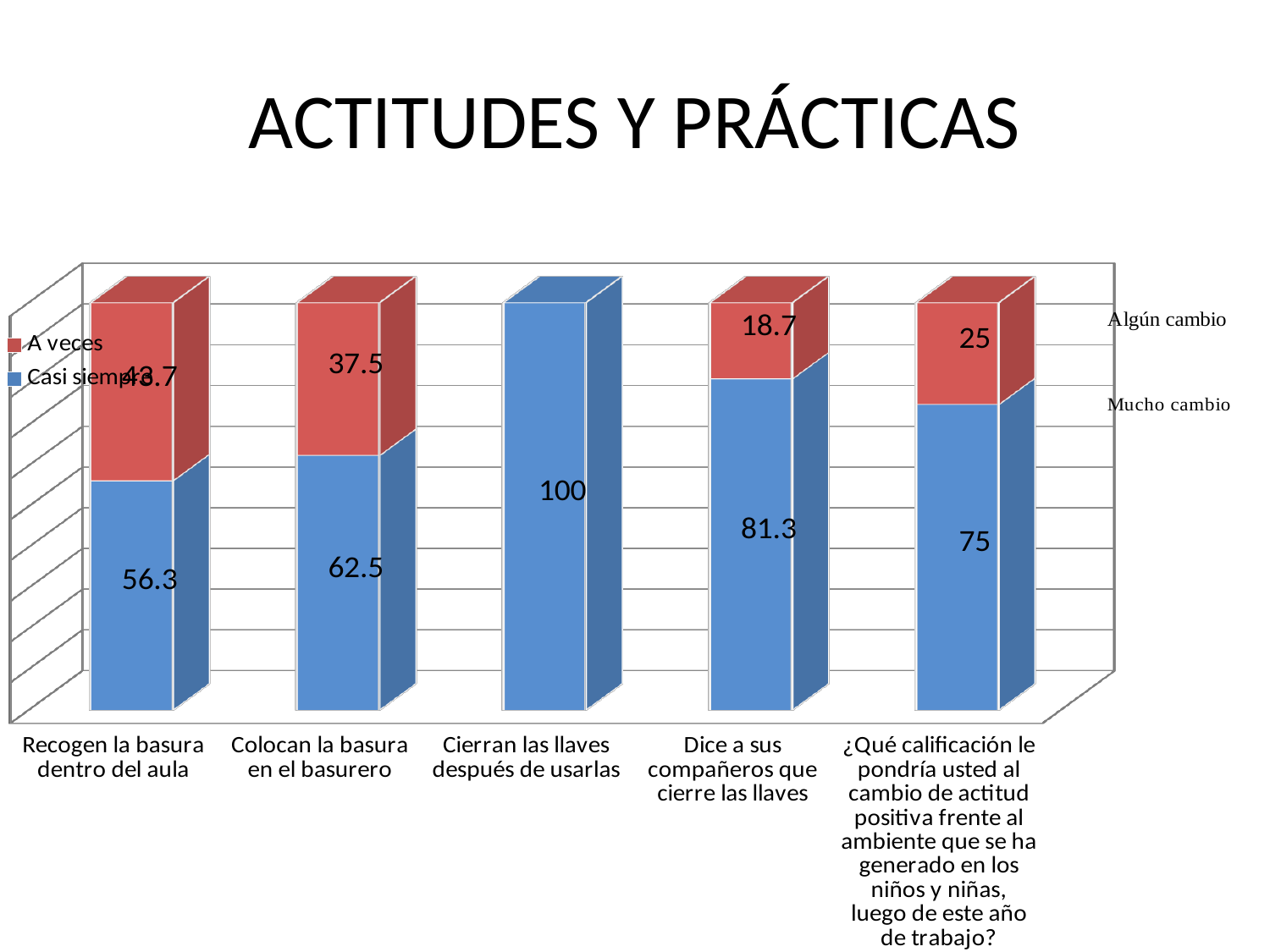
What is the value of the 'A veces' series for the category '¿Qué calificación le pondría usted al cambio de actitud positiva...'? 25 What is the value of the 'Casi siempre' series for 'Colocan la basura en el basurero'? 62.5 What is the total of the stacked bar for 'Colocan la basura en el basurero'? 100 Which category has the highest 'Casi siempre' value? Cierran las llaves después de usarlas Which has a larger 'Casi siempre' value: 'Colocan la basura en el basurero' or 'Recogen la basura dentro del aula'? Colocan la basura en el basurero What is the value of the 'A veces' series for 'Dice a sus compañeros que cierre las llaves'? 18.7 Which category has the lowest 'Casi siempre' value? Recogen la basura dentro del aula What is the difference between the 'Casi siempre' and 'A veces' values for 'Dice a sus compañeros que cierre las llaves'? 62.6 How many categories are shown on the x axis of the chart? 5 What is the value of the 'Casi siempre' series for 'Cierran las llaves después de usarlas'? 100 How many series does the chart legend list? 2 What kind of chart is shown on the slide? Stacked bar chart